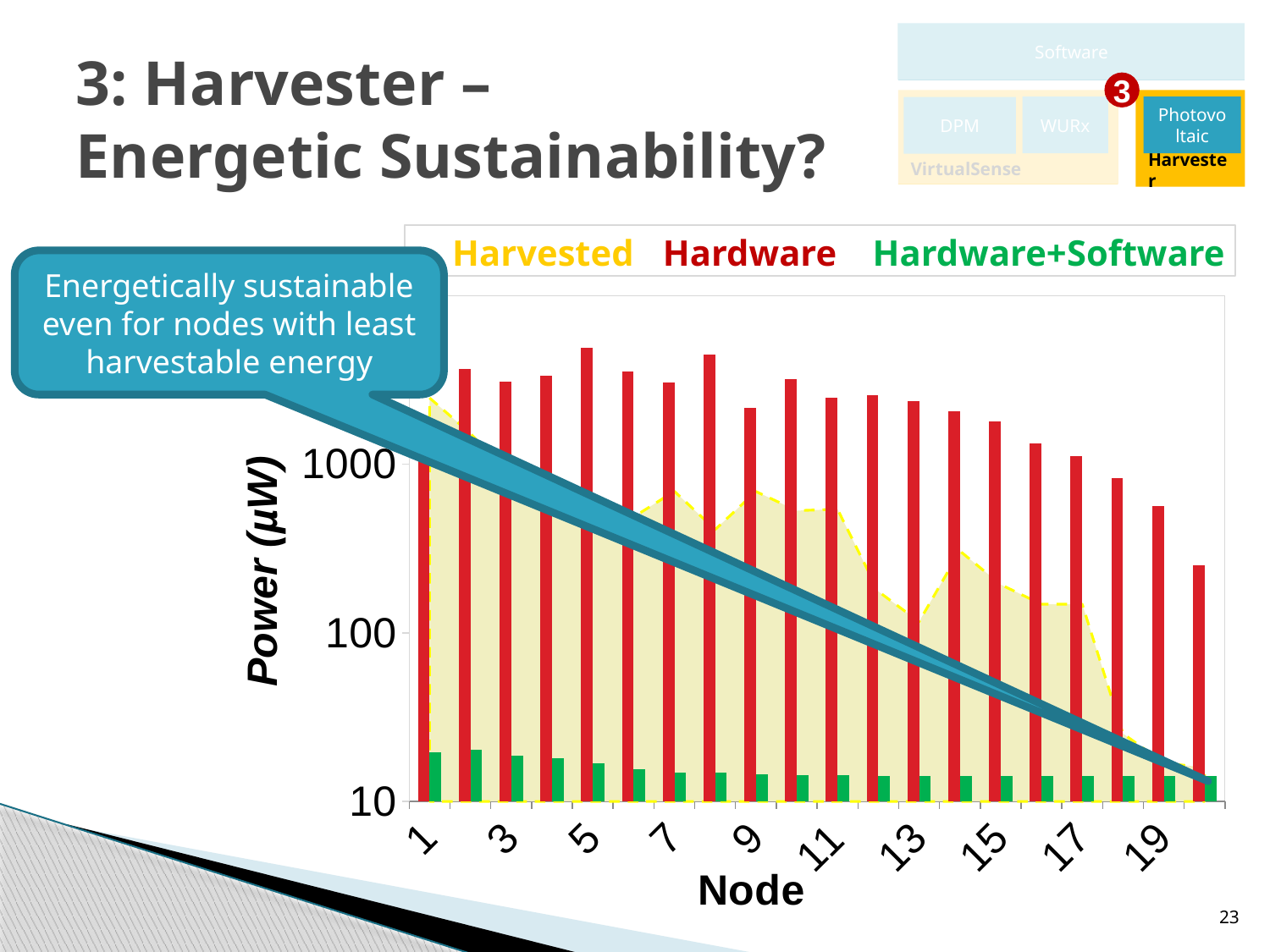
Do the Hardware values generally rise or fall from node 1 to node 20? fall At node 1, which is larger: Hardware or Hardware+Software? Hardware Which series are listed in the legend? Harvested, Hardware, Hardware+Software How many nodes are plotted along the x axis? 20 What is the label of the y axis? Power (µW) Which node has the lowest Hardware value? 20 Is the Hardware value for node 20 greater or less than 100? greater How many series does the legend list? 3 What kind of chart is shown on the slide? combination area and bar chart Is the Hardware value for node 1 greater or less than 1000? greater Is the Hardware+Software value for node 10 greater or less than 100? less Which is larger: the Hardware value for node 1 or for node 20? node 1